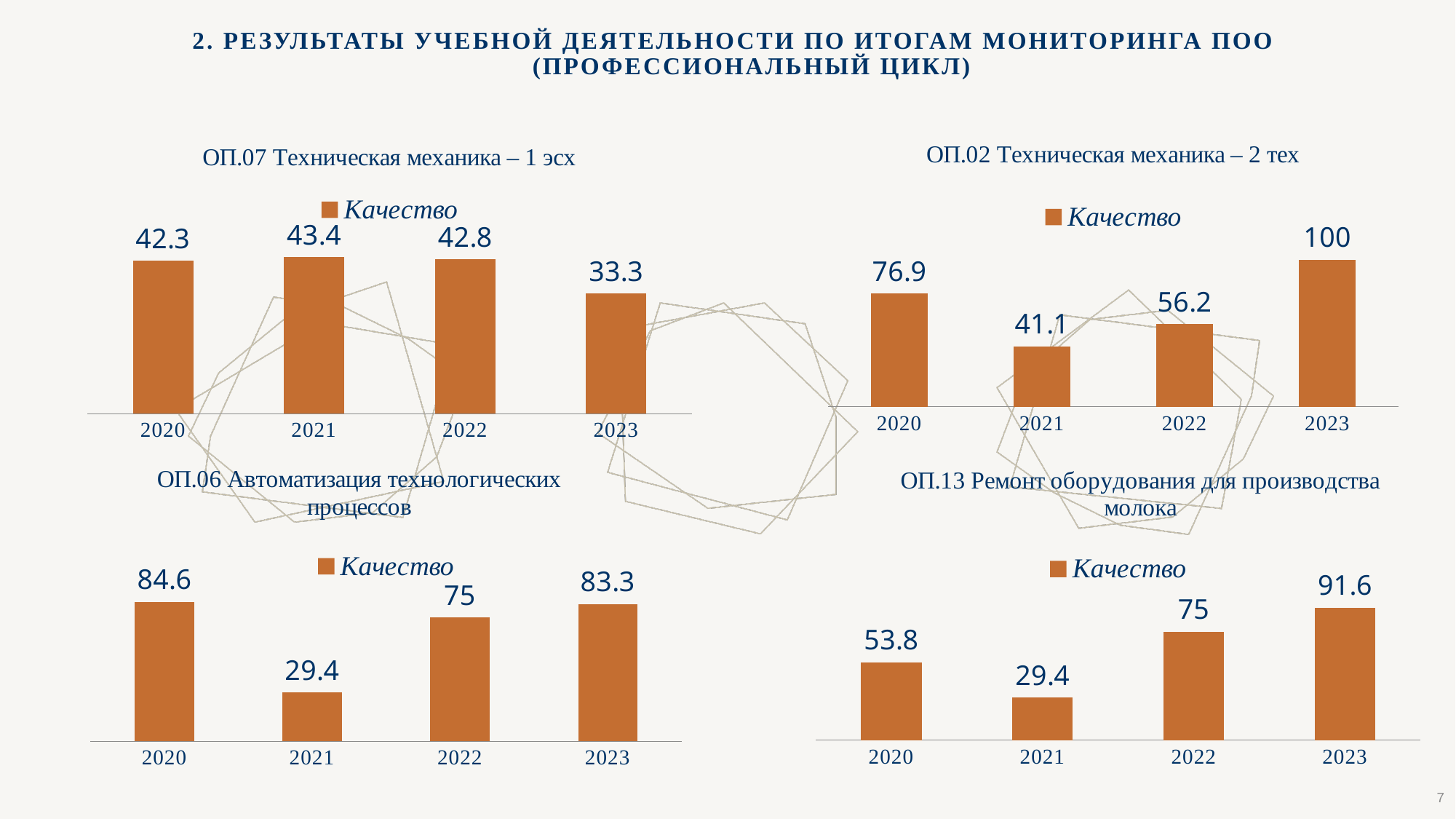
How many bars are shown in the chart 'ОП.07 Техническая механика – 1 эсх'? 4 In the chart 'ОП.02 Техническая механика – 2 тех', what is the value for 2020? 76.9 In the chart 'ОП.07 Техническая механика – 1 эсх', which year has the highest value? 2021 In the chart 'ОП.02 Техническая механика – 2 тех', which year has the lowest value? 2021 In the chart 'ОП.13 Ремонт оборудования для производства молока', do the values rise or fall from 2021 to 2023? rise In the chart 'ОП.13 Ремонт оборудования для производства молока', what is the difference between the values for 2022 and 2020? 21.2 In the chart 'ОП.06 Автоматизация технологических процессов', which is larger, the value for 2020 or the value for 2023? 2020 In the chart 'ОП.02 Техническая механика – 2 тех', what is the difference between the values for 2023 and 2022? 43.8 What type of chart is 'ОП.02 Техническая механика – 2 тех'? bar chart In the chart 'ОП.13 Ремонт оборудования для производства молока', what is the value for 2023? 91.6 In the chart 'ОП.07 Техническая механика – 1 эсх', what is the value for 2023? 33.3 In the chart 'ОП.06 Автоматизация технологических процессов', what is the value for 2021? 29.4